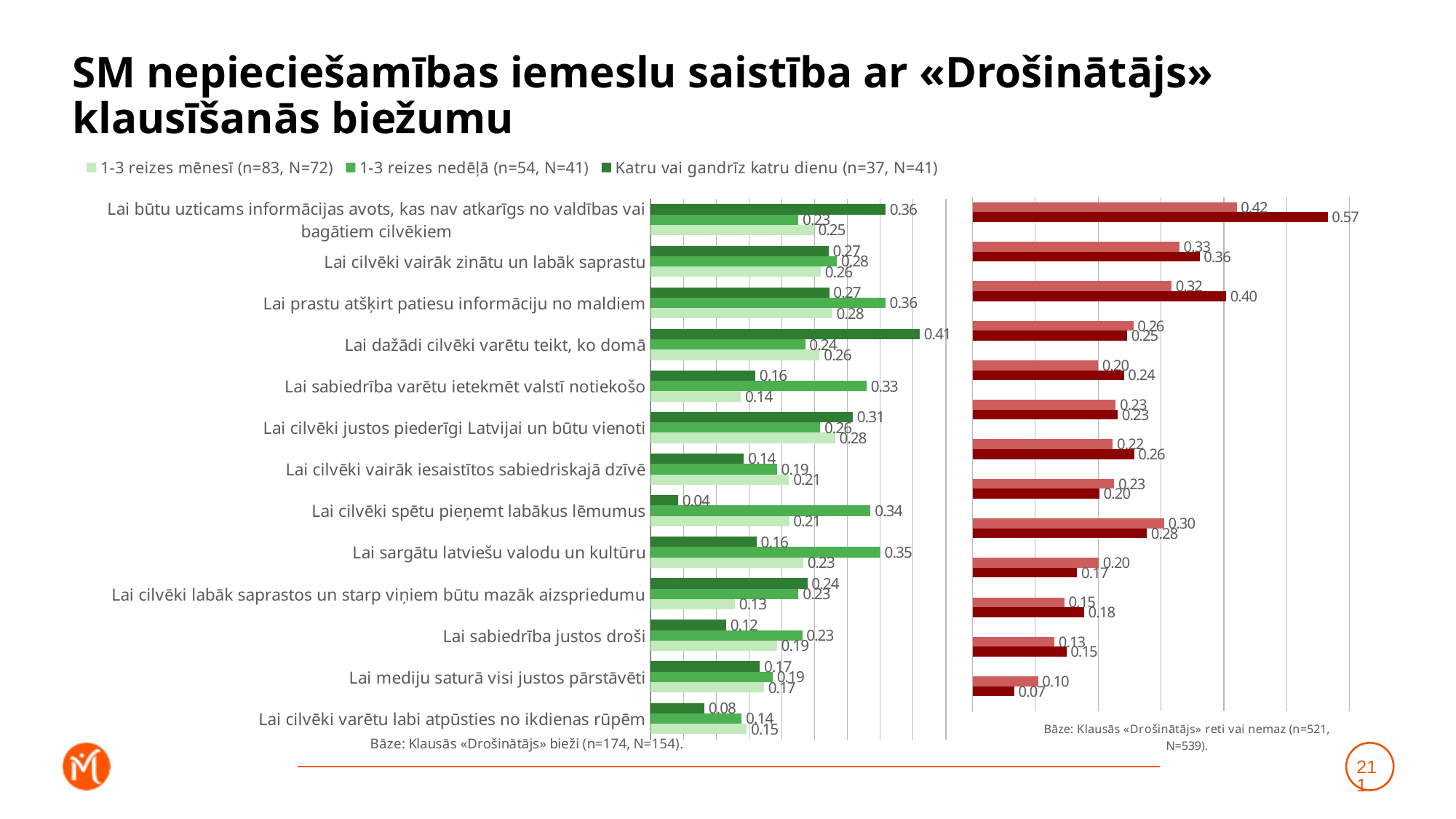
On the left (green) chart, which category has the highest value for "Katru vai gandrīz katru dienu"? Lai dažādi cilvēki varētu teikt, ko domā On the right (red) chart, what is the highest value shown for "Lai būtu uzticams informācijas avots, kas nav atkarīgs no valdības vai bagātiem cilvēkiem"? 0.57 On the left (green) chart, what is the difference between the "1-3 reizes nedēļā" and "Katru vai gandrīz katru dienu" values for "Lai sargātu latviešu valodu un kultūru"? 0.19 What type of chart is used on this slide? Bar chart On the left (green) chart, which category has the lowest value for "Katru vai gandrīz katru dienu"? Lai cilvēki spētu pieņemt labākus lēmumus On the right (red) chart, what is the lowest value shown for "Lai cilvēki varētu labi atpūsties no ikdienas rūpēm"? 0.07 On the left (green) chart, for "Lai būtu uzticams informācijas avots, kas nav atkarīgs no valdības vai bagātiem cilvēkiem", which is larger: "Katru vai gandrīz katru dienu" or "1-3 reizes mēnesī"? Katru vai gandrīz katru dienu On the left (green) chart, what is the value for "1-3 reizes mēnesī" for "Lai sabiedrība varētu ietekmēt valstī notiekošo"? 0.14 How many categories are shown on the left (green) chart? 13 On the left (green) chart, what is the value for "Katru vai gandrīz katru dienu" for "Lai dažādi cilvēki varētu teikt, ko domā"? 0.41 On the left (green) chart, what is the value for "1-3 reizes nedēļā" for "Lai cilvēki spētu pieņemt labākus lēmumus"? 0.34 How many series does the legend of the left (green) chart list? 3